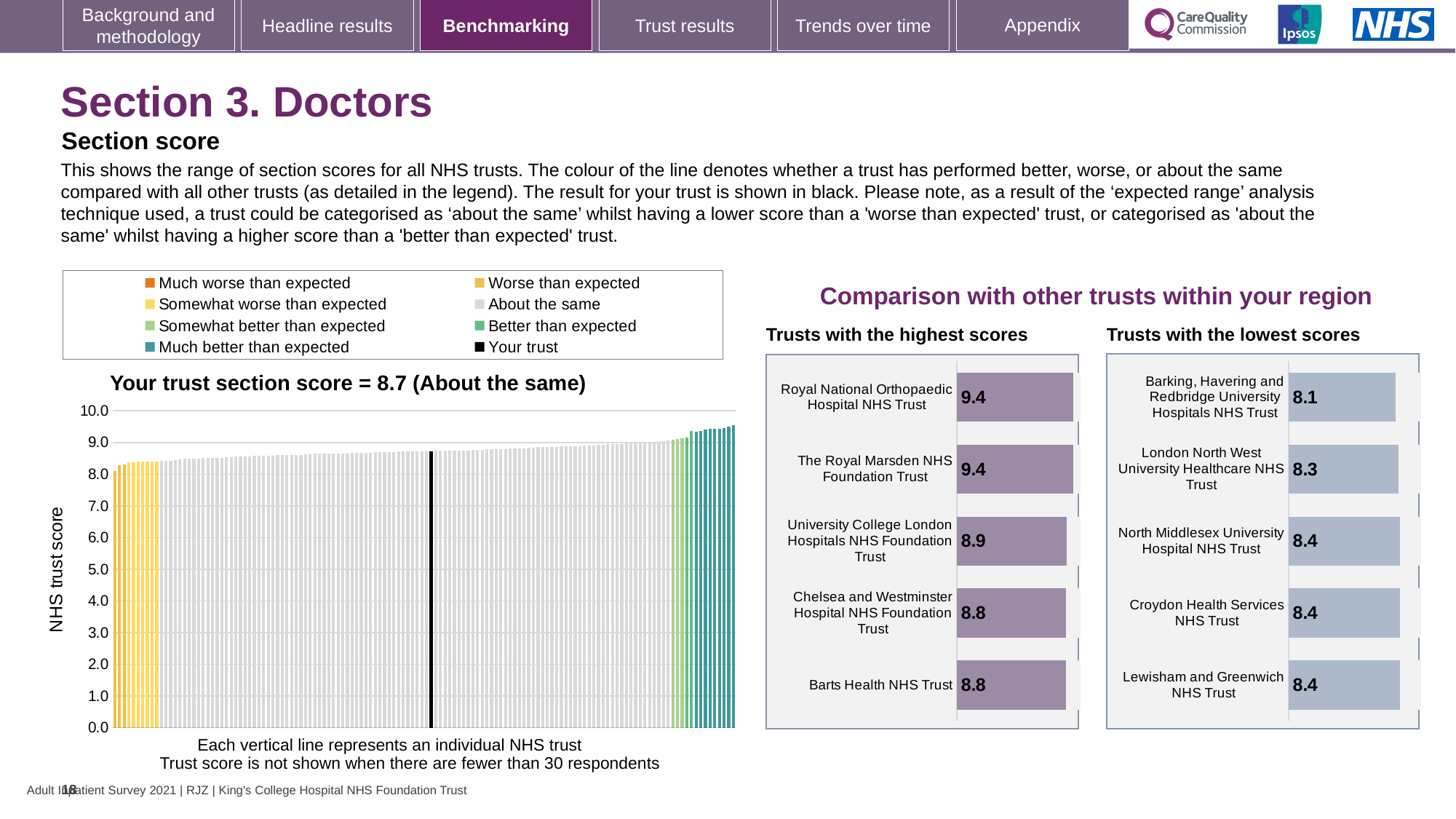
In the 'Trusts with the lowest scores' chart, what is the difference between the score for Croydon Health Services NHS Trust and the score for Barking, Havering and Redbridge University Hospitals NHS Trust? 0.3 What is the title of the main chart on the left? Your trust section score = 8.7 (About the same) In the 'Trusts with the highest scores' chart, what is the score for University College London Hospitals NHS Foundation Trust? 8.9 In the 'Trusts with the highest scores' chart, what is the score for Barts Health NHS Trust? 8.8 In the 'Trusts with the highest scores' chart, which has the larger score: The Royal Marsden NHS Foundation Trust or Chelsea and Westminster Hospital NHS Foundation Trust? The Royal Marsden NHS Foundation Trust In the 'Trusts with the lowest scores' chart, what is the score for London North West University Healthcare NHS Trust? 8.3 In the 'Trusts with the highest scores' chart, what is the difference between the score for Royal National Orthopaedic Hospital NHS Trust and the score for Barts Health NHS Trust? 0.6 In the 'Trusts with the lowest scores' chart, which trust has the lowest score? Barking, Havering and Redbridge University Hospitals NHS Trust How many trusts are listed in the 'Trusts with the lowest scores' chart? 5 What kind of chart is the main chart on the left showing the range of section scores? Bar chart How many entries does the legend of the main chart on the left list? 8 In the main chart on the left, is the value for 'Your trust' greater or less than 8.0? greater